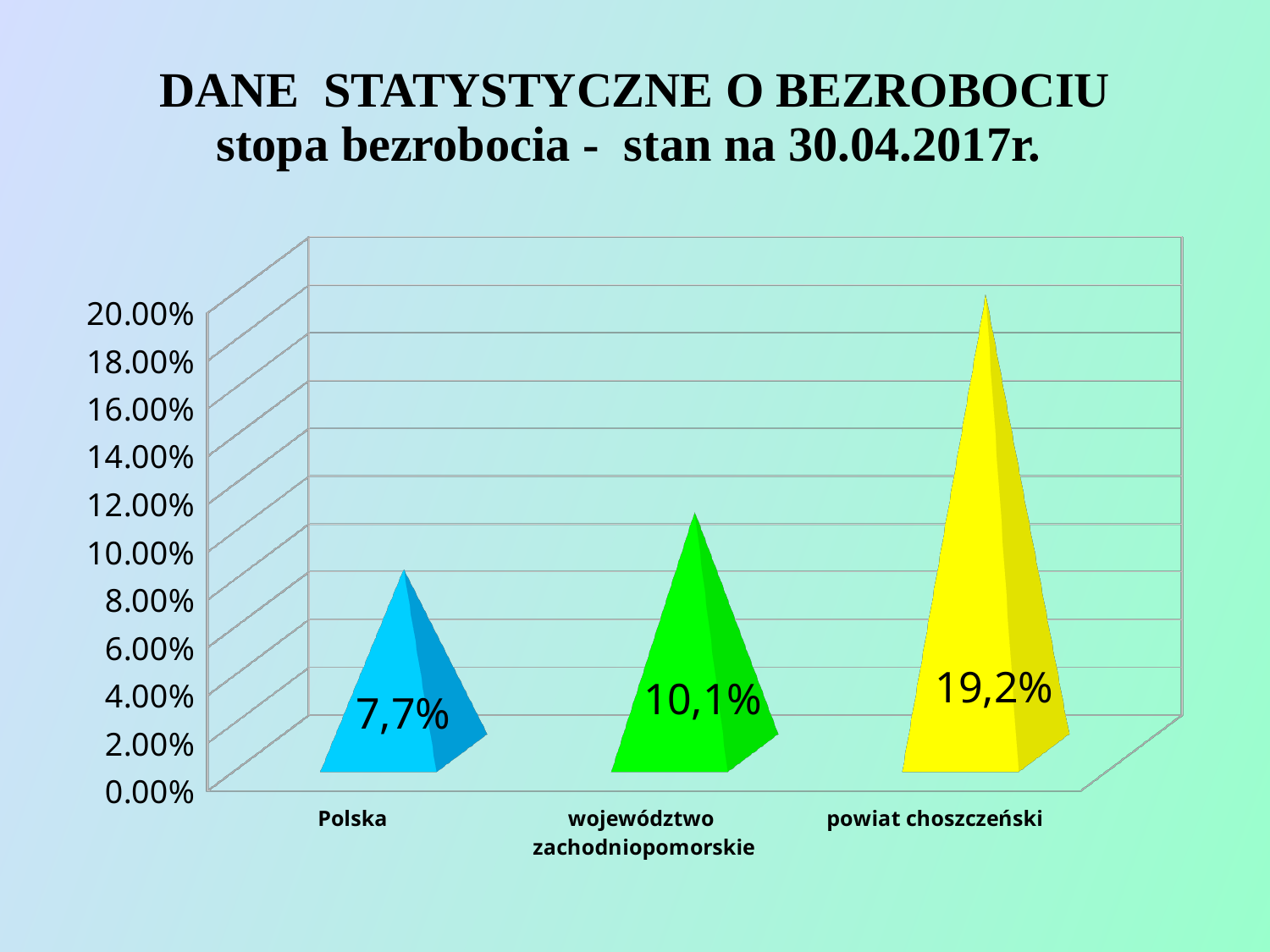
What is the unemployment rate shown for Polska? 7,7% Which category has the highest unemployment rate? powiat choszczeński Which category has the lowest unemployment rate? Polska Which is larger, the value for województwo zachodniopomorskie or the value for Polska? województwo zachodniopomorskie Is the value for powiat choszczeński greater or less than 18.00%? greater How many categories are shown on the chart? 3 What kind of chart is shown on the slide? bar chart What is the unemployment rate shown for województwo zachodniopomorskie? 10,1% What is the difference between the unemployment rate for powiat choszczeński and Polska? 11,5% What is the difference between the unemployment rate for województwo zachodniopomorskie and Polska? 2,4% What is the unemployment rate shown for powiat choszczeński? 19,2% Do the values rise or fall from left to right across the categories? rise